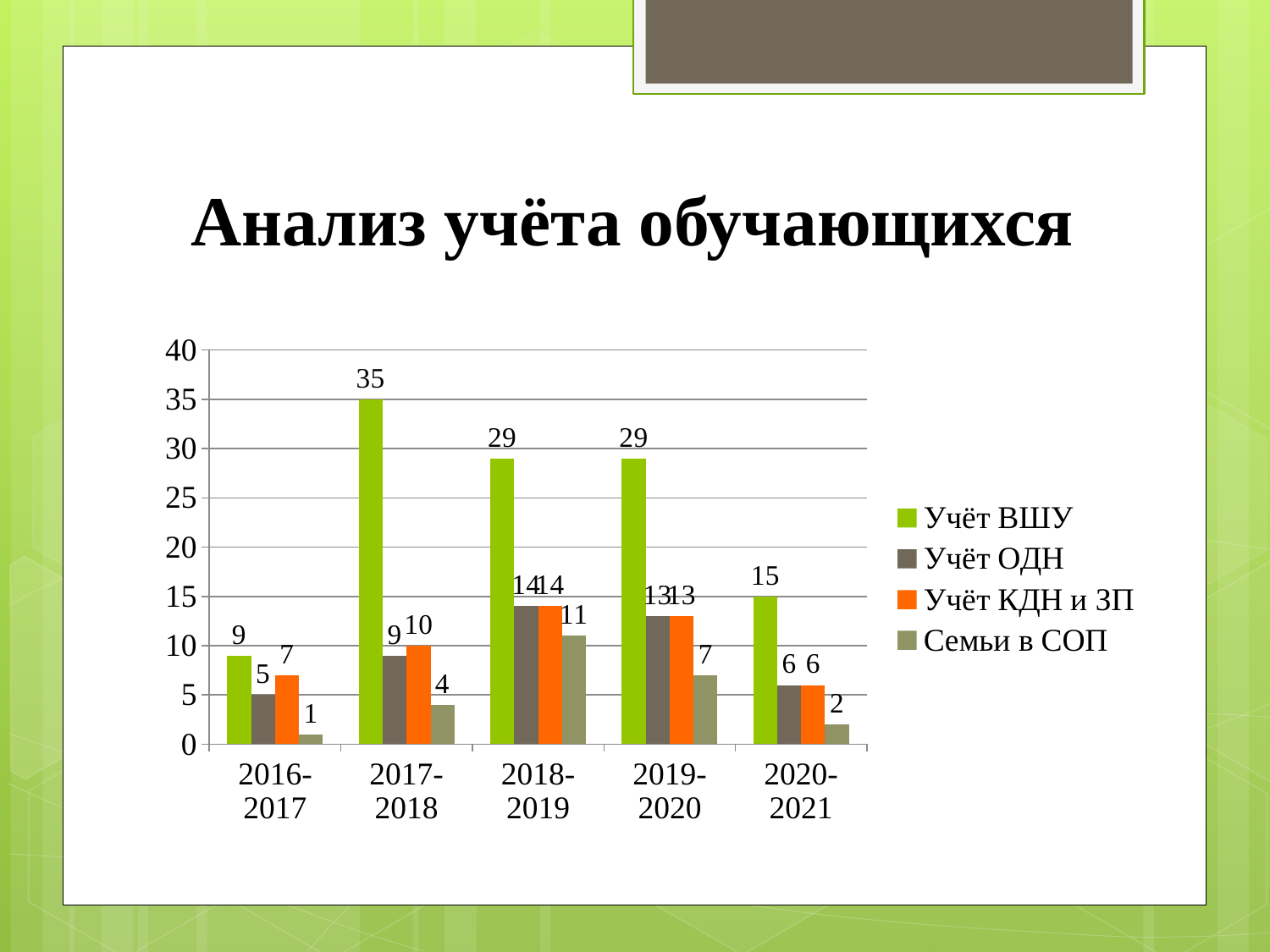
How many year categories are shown on the x axis? 5 What is the value for Учёт ВШУ in 2017-2018? 35 What is the title of the slide? Анализ учёта обучающихся Which year has the lowest value for Учёт ОДН? 2016-2017 Which year has the highest value for Учёт ВШУ? 2017-2018 What is the difference between Учёт ВШУ in 2017-2018 and in 2020-2021? 20 Does the value for Семьи в СОП rise or fall from 2018-2019 to 2020-2021? fall Which is larger: Семьи в СОП in 2018-2019 or Семьи в СОП in 2019-2020? 2018-2019 What is the value for Семьи в СОП in 2016-2017? 1 How many series does the legend list? 4 What is the value for Учёт КДН и ЗП in 2019-2020? 13 What kind of chart is shown on the slide? bar chart